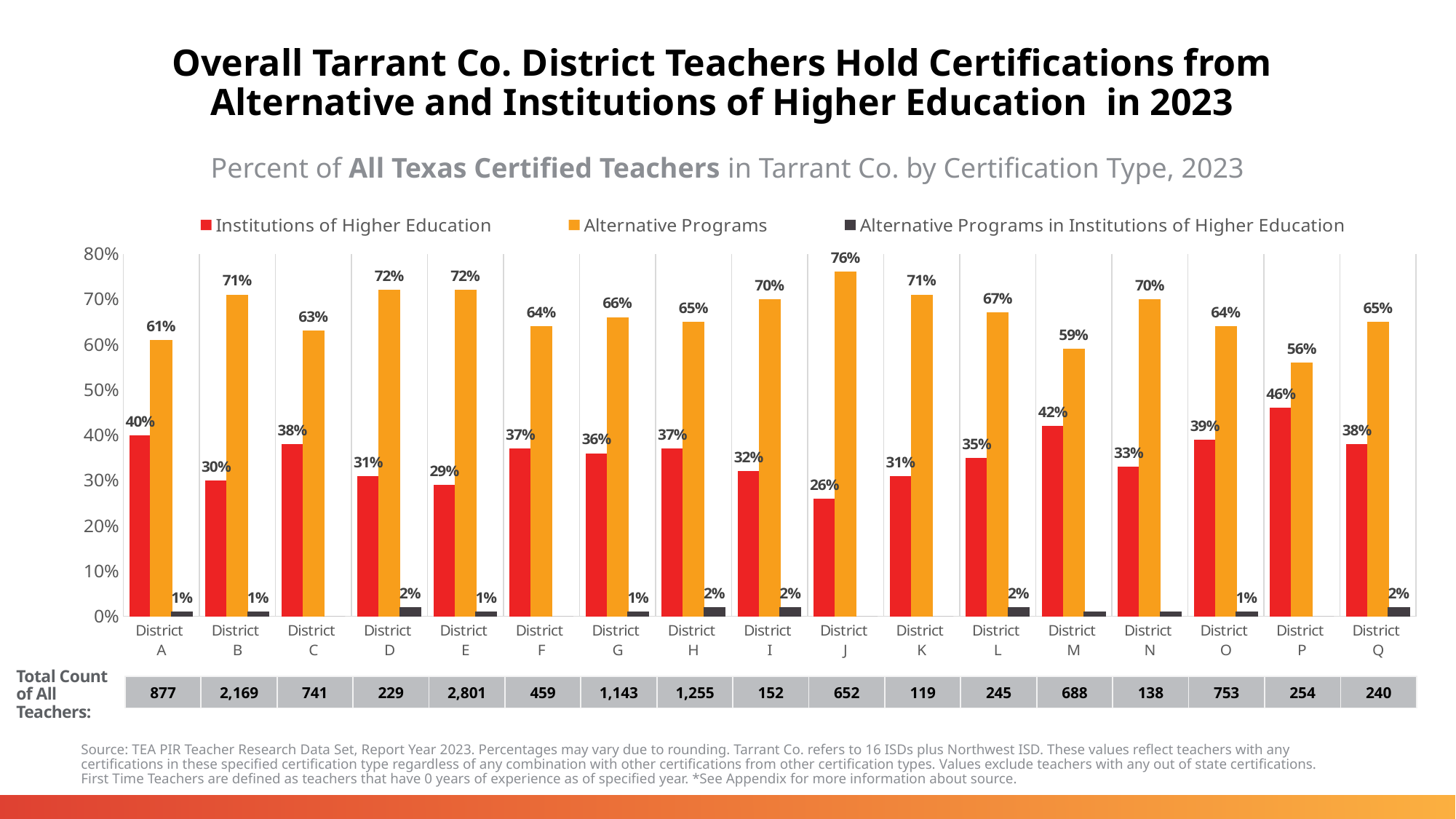
Which district has the lowest percentage of teachers certified through Alternative Programs? District P Which is larger for District M: the Institutions of Higher Education percentage or the Alternative Programs percentage? Alternative Programs How many districts are shown on the x axis of the chart? 17 How many series does the chart legend list? 3 What percentage of teachers in District J hold certifications from Alternative Programs? 76% What is the Total Count of All Teachers shown for District E? 2,801 What kind of chart is shown on the slide? Bar chart What percentage of teachers in District P hold certifications from Institutions of Higher Education? 46% Which district has the lowest percentage of teachers certified through Institutions of Higher Education? District J Which district has the highest percentage of teachers certified through Alternative Programs? District J What is the difference between the Alternative Programs percentage and the Institutions of Higher Education percentage for District A? 21% What colour represents the Alternative Programs series in the chart? Orange